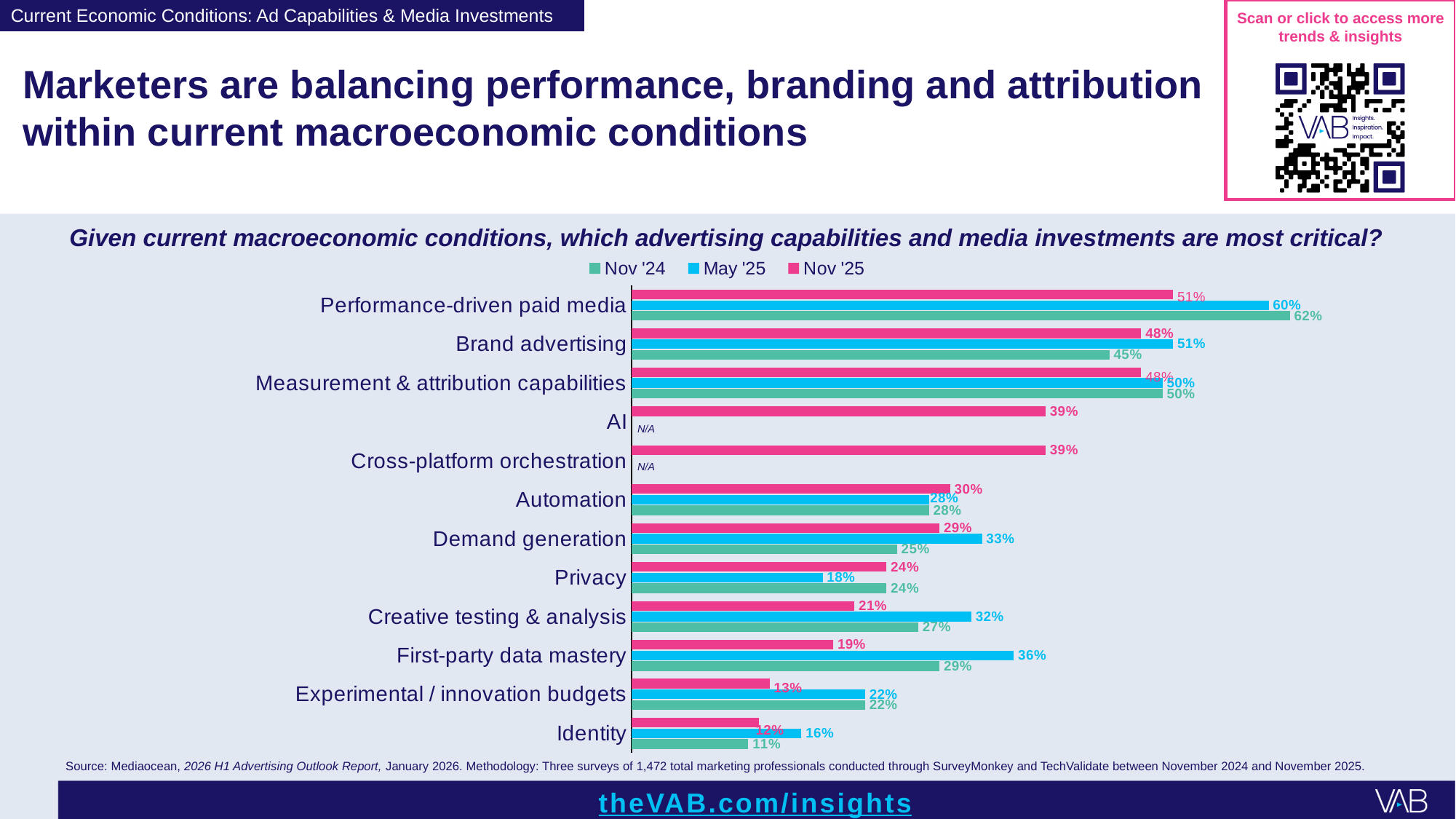
Which category has the highest Nov '25 value? Performance-driven paid media What is the difference between the May '25 and Nov '25 values for Creative testing & analysis? 11% Which category has the lowest Nov '24 value? Identity How many series does the legend list? 3 What is the Nov '25 value for AI? 39% What kind of chart is shown on the slide? Bar chart How many categories are shown on the chart? 12 What is the May '25 value for Privacy? 18% Which is larger for Brand advertising: the Nov '24 value or the May '25 value? May '25 What is the Nov '24 value for Performance-driven paid media? 62% What is the May '25 value for First-party data mastery? 36% Which two categories show N/A for the Nov '24 and May '25 surveys? AI and Cross-platform orchestration